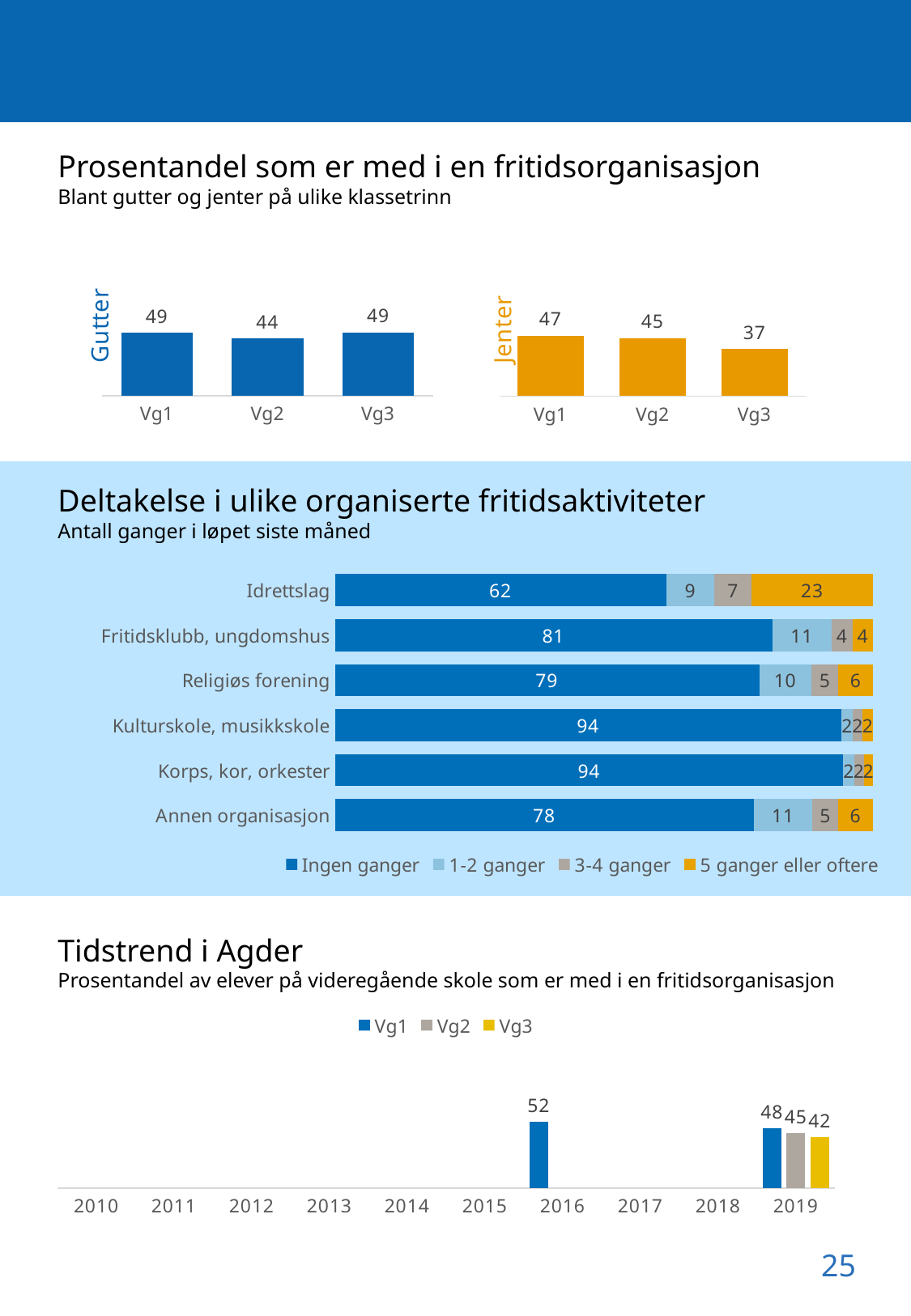
In the 'Prosentandel som er med i en fritidsorganisasjon' chart, what is the difference between Gutter Vg3 and Jenter Vg3? 12 In the 'Deltakelse i ulike organiserte fritidsaktiviteter' chart, what is the '5 ganger eller oftere' value for Idrettslag? 23 In the 'Tidstrend i Agder' chart, what is the Vg1 value for 2016? 52 In the 'Prosentandel som er med i en fritidsorganisasjon' chart, which class level has the lowest value among Jenter? Vg3 In the 'Deltakelse i ulike organiserte fritidsaktiviteter' chart, what is the 'Ingen ganger' value for Idrettslag? 62 In the 'Prosentandel som er med i en fritidsorganisasjon' chart, what is the value for Vg3 among Jenter? 37 In the 'Deltakelse i ulike organiserte fritidsaktiviteter' chart, how many activity categories are shown? 6 What kind of chart is the 'Tidstrend i Agder' chart? Bar chart In the 'Tidstrend i Agder' chart, what is the Vg3 value for 2019? 42 In the 'Deltakelse i ulike organiserte fritidsaktiviteter' chart, how many series does the legend list? 4 In the 'Deltakelse i ulike organiserte fritidsaktiviteter' chart, which activity has the highest 'Ingen ganger' value? Kulturskole, musikkskole and Korps, kor, orkester (94) In the 'Prosentandel som er med i en fritidsorganisasjon' chart, what is the value for Vg2 among Gutter? 44